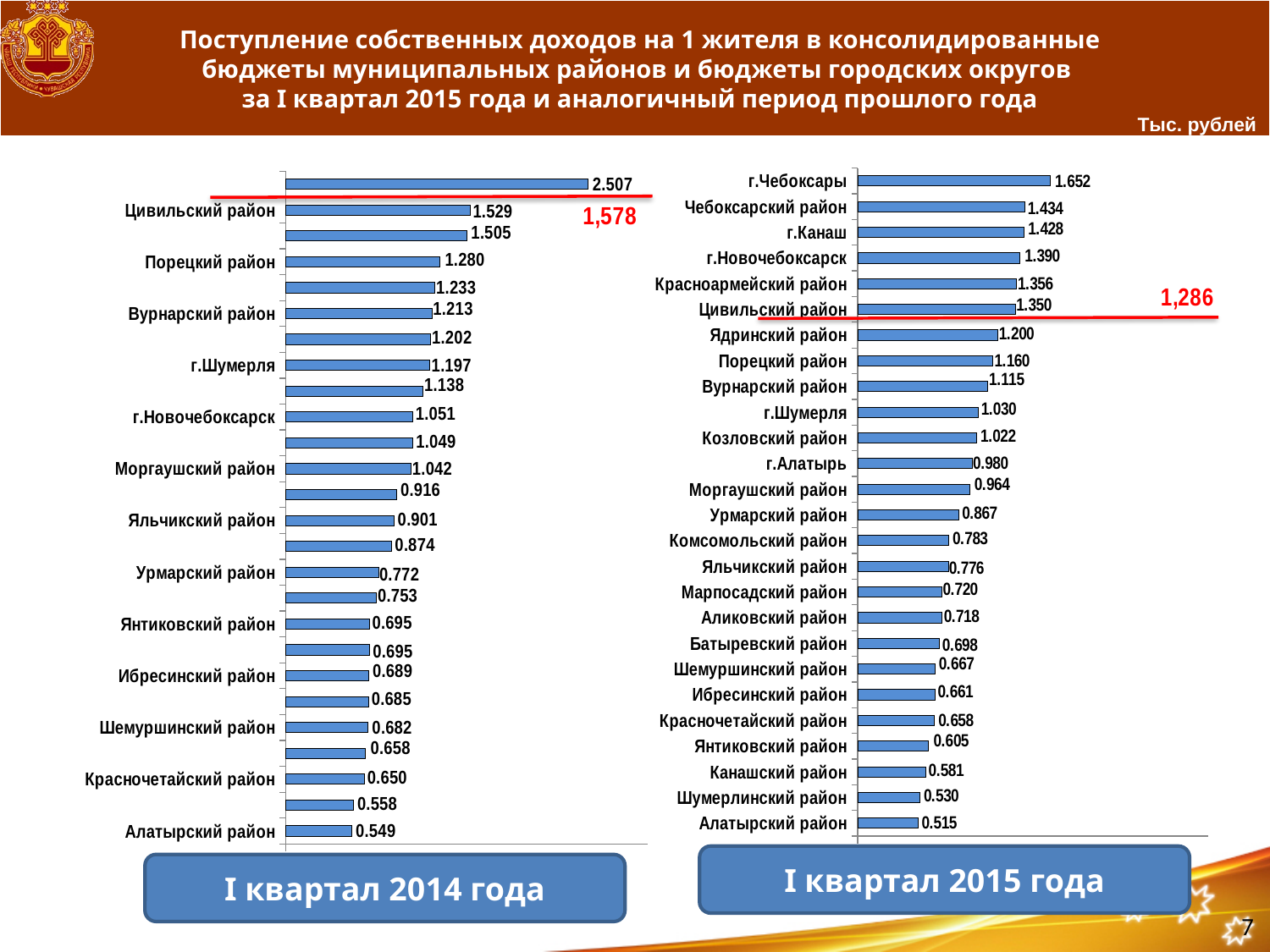
In the right chart (I квартал 2015 года), what is the value for Козловский район? 1.022 In the right chart (I квартал 2015 года), which category has the lowest value? Алатырский район In the right chart (I квартал 2015 года), what is the difference between the values for г.Чебоксары and Алатырский район? 1.137 In the right chart (I квартал 2015 года), which category has the highest value? г.Чебоксары In the right chart (I квартал 2015 года), which is larger: the value for Порецкий район or the value for г.Шумерля? Порецкий район In the left chart (I квартал 2014 года), what is the value for Порецкий район? 1.280 In the left chart (I квартал 2014 года), what is the value for Красночетайский район? 0.650 How many categories are shown in the right chart (I квартал 2015 года)? 26 In the right chart (I квартал 2015 года), what is the value for г.Чебоксары? 1.652 What kind of chart is used for I квартал 2015 года? Bar chart What value is marked by the red line in the right chart (I квартал 2015 года)? 1,286 In the left chart (I квартал 2014 года), which is larger: the value for Цивильский район or the value for Вурнарский район? Цивильский район